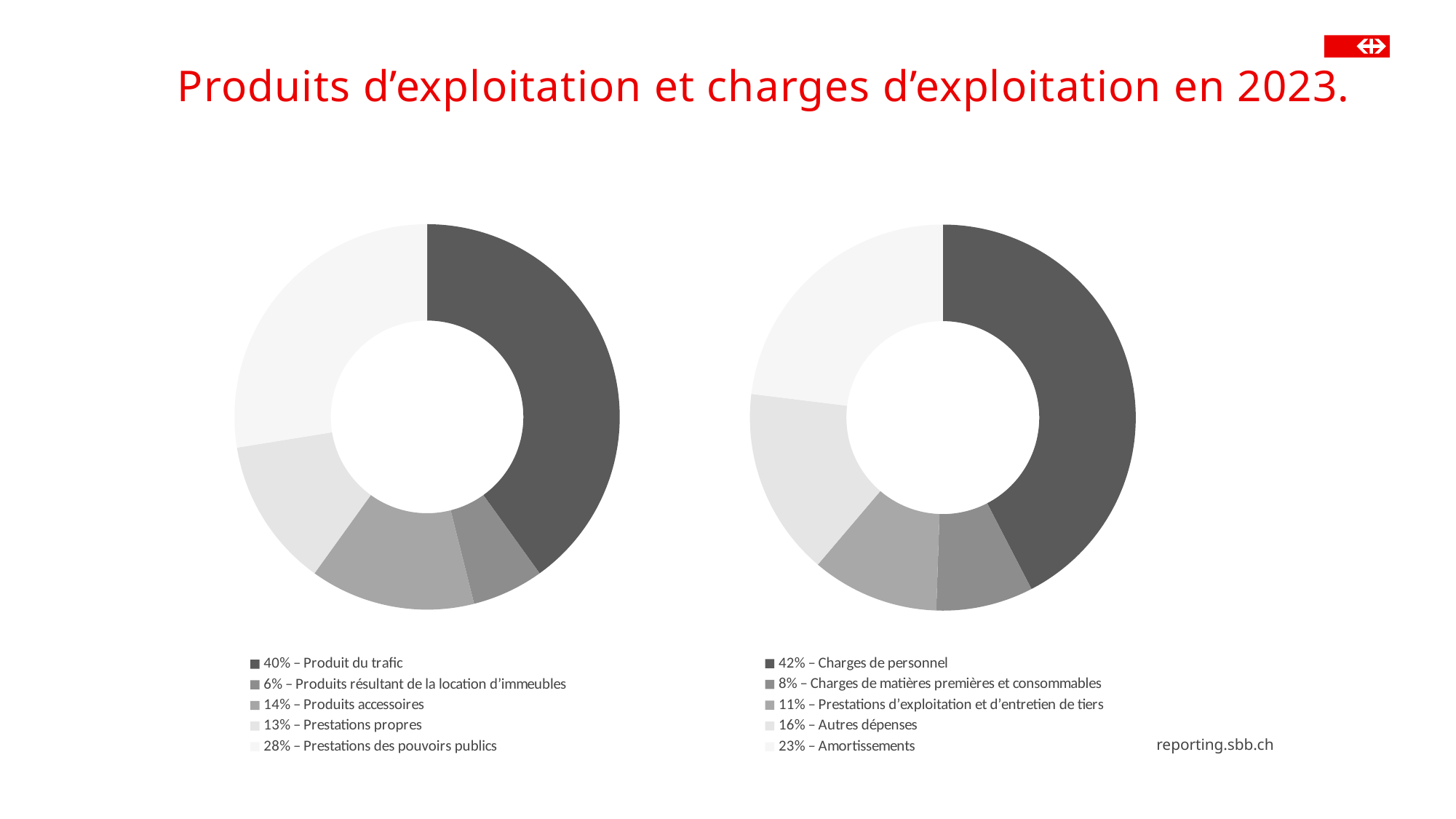
What is the title of the slide? Produits d'exploitation et charges d'exploitation en 2023. What kind of chart is the right chart? Doughnut chart How many categories does the left chart's legend list? 5 In the left chart, what is the difference in percentage points between Produit du trafic and Prestations des pouvoirs publics? 12 In the right chart, what share is Amortissements? 23% In the right chart, which is larger: Autres dépenses or Prestations d'exploitation et d'entretien de tiers? Autres dépenses In the right chart, what share is Charges de personnel? 42% In the left chart, which category has the smallest share? Produits résultant de la location d'immeubles In the right chart, which category has the smallest share? Charges de matières premières et consommables In the right chart, which category has the largest share? Charges de personnel In the left chart, what share is Prestations des pouvoirs publics? 28% In the left chart, what share is Produit du trafic? 40%